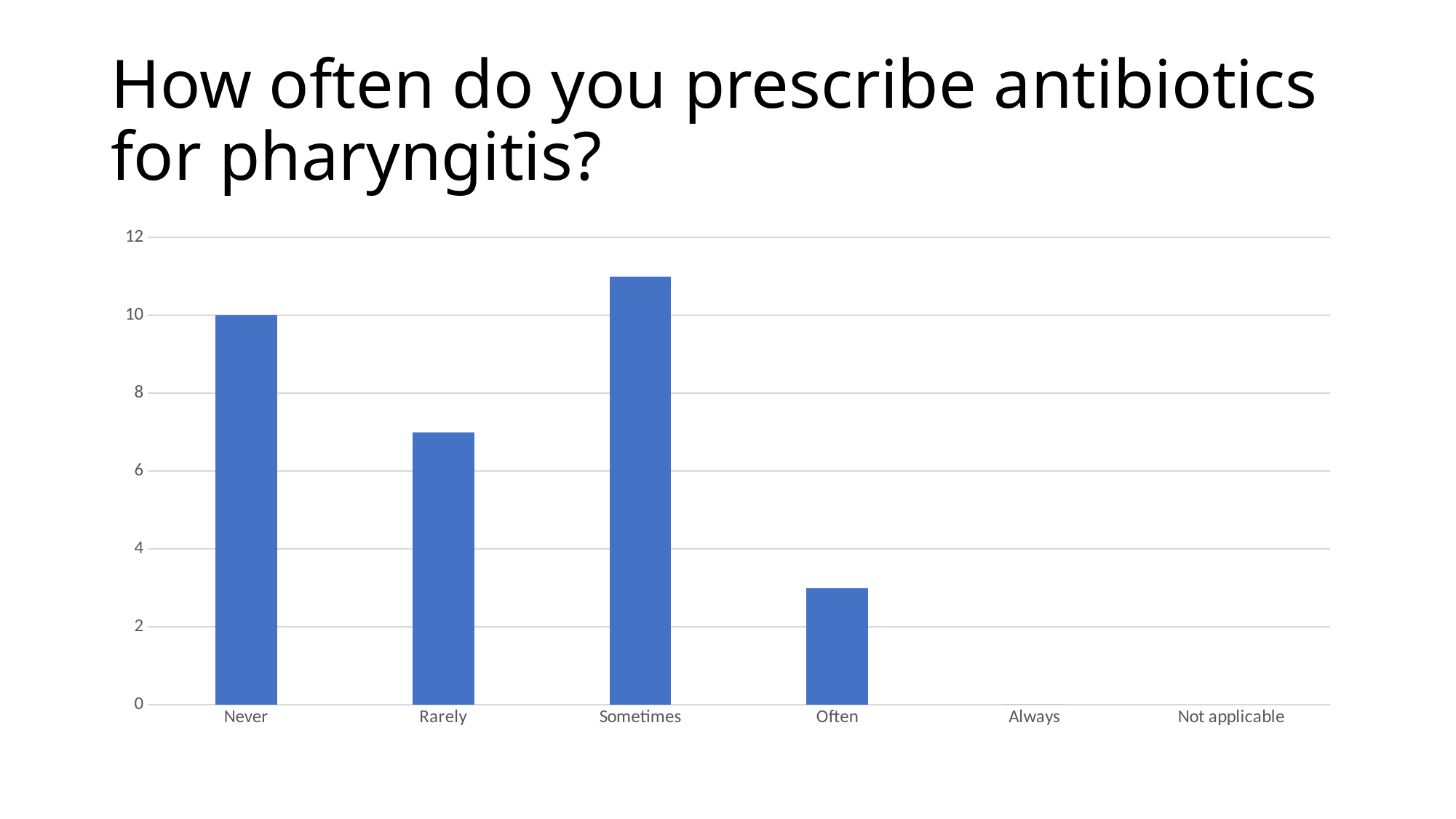
How many categories are shown on the x axis? 6 What type of chart is shown on the slide? bar chart Is the value for Sometimes greater or less than 10? greater What is the value for Never? 10 What is the value for Always? 0 Which is larger, the value for Never or the value for Rarely? Never Is the value for Often greater or less than 4? less What is the title of the chart on the slide? How often do you prescribe antibiotics for pharyngitis? Which is larger, the value for Often or the value for Sometimes? Sometimes Which category has the highest value? Sometimes Is the value for Rarely greater or less than 8? less